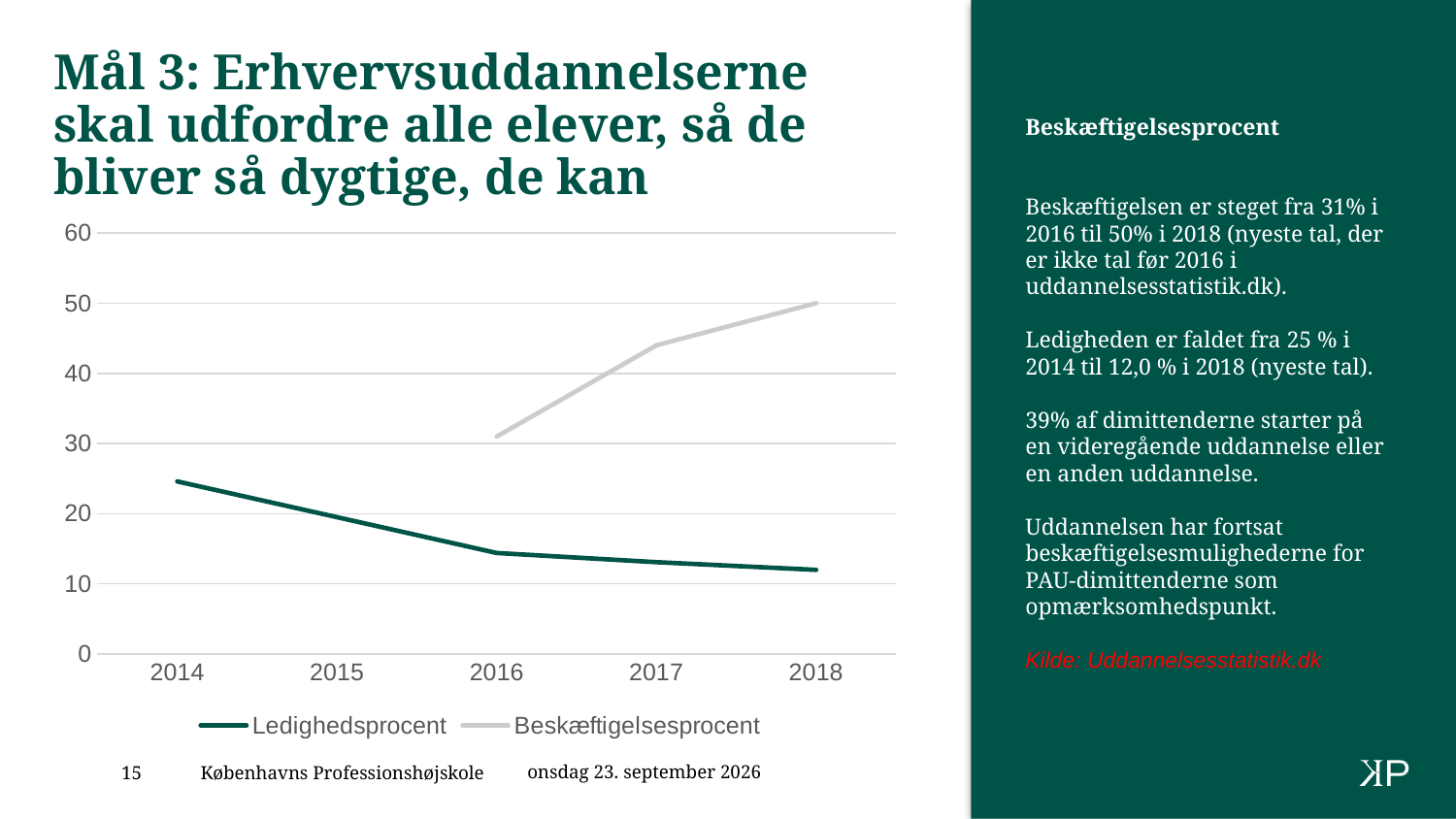
What kind of chart is shown on the slide? Line chart In 2018, which series has the higher value, Ledighedsprocent or Beskæftigelsesprocent? Beskæftigelsesprocent Which series is drawn with the light grey line? Beskæftigelsesprocent In which year does the Beskæftigelsesprocent line start? 2016 Does the Ledighedsprocent line rise or fall from 2014 to 2018? Fall How many years are shown on the x axis of the chart? 5 How many series does the chart legend list? 2 Does the Beskæftigelsesprocent line rise or fall from 2016 to 2018? Rise Is the Ledighedsprocent value for 2018 greater or less than 20? less Is the Ledighedsprocent value for 2014 greater or less than 20? greater Is the Beskæftigelsesprocent value for 2017 greater or less than 40? greater